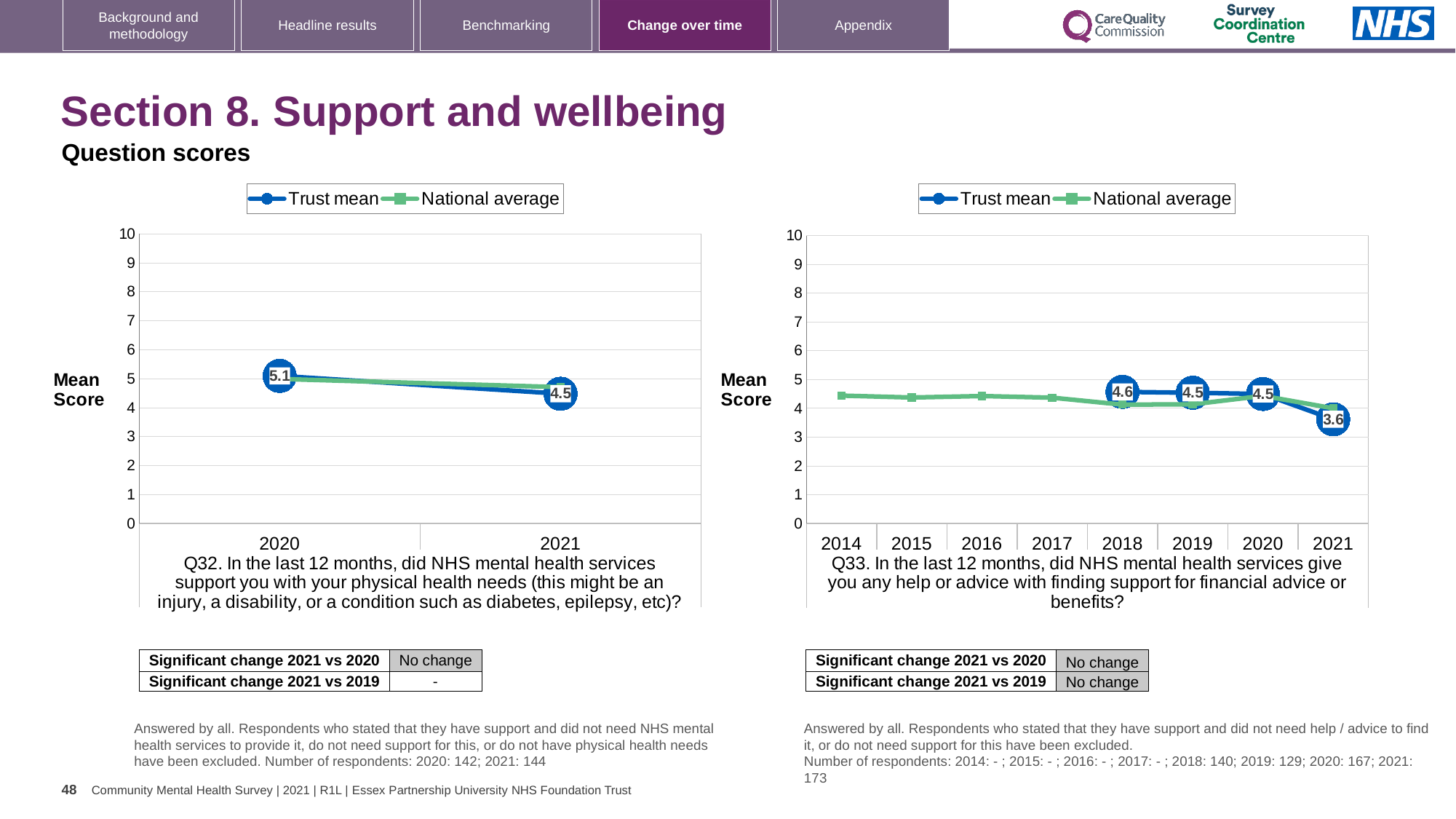
On the Q32 chart (left), by how much did the Trust mean fall from 2020 to 2021? 0.6 On the Q33 chart (right), which year has the lowest Trust mean score? 2021 On the Q32 chart (left), does the Trust mean rise or fall from 2020 to 2021? fall What kind of chart is the Q33 chart (right)? line chart How many series does the legend of the Q33 chart (right) list? 2 On the Q33 chart (right), is the National average for 2014 greater or less than 5? less On the Q32 chart (left), what is the Trust mean score for 2021? 4.5 On the Q32 chart (left), what is the Trust mean score for 2020? 5.1 On the Q32 chart (left), how many years are shown on the x axis? 2 On the Q33 chart (right), what is the Trust mean score for 2021? 3.6 On the Q33 chart (right), what is the difference between the Trust mean in 2018 and in 2021? 1.0 On the Q33 chart (right), which year has the highest Trust mean score? 2018